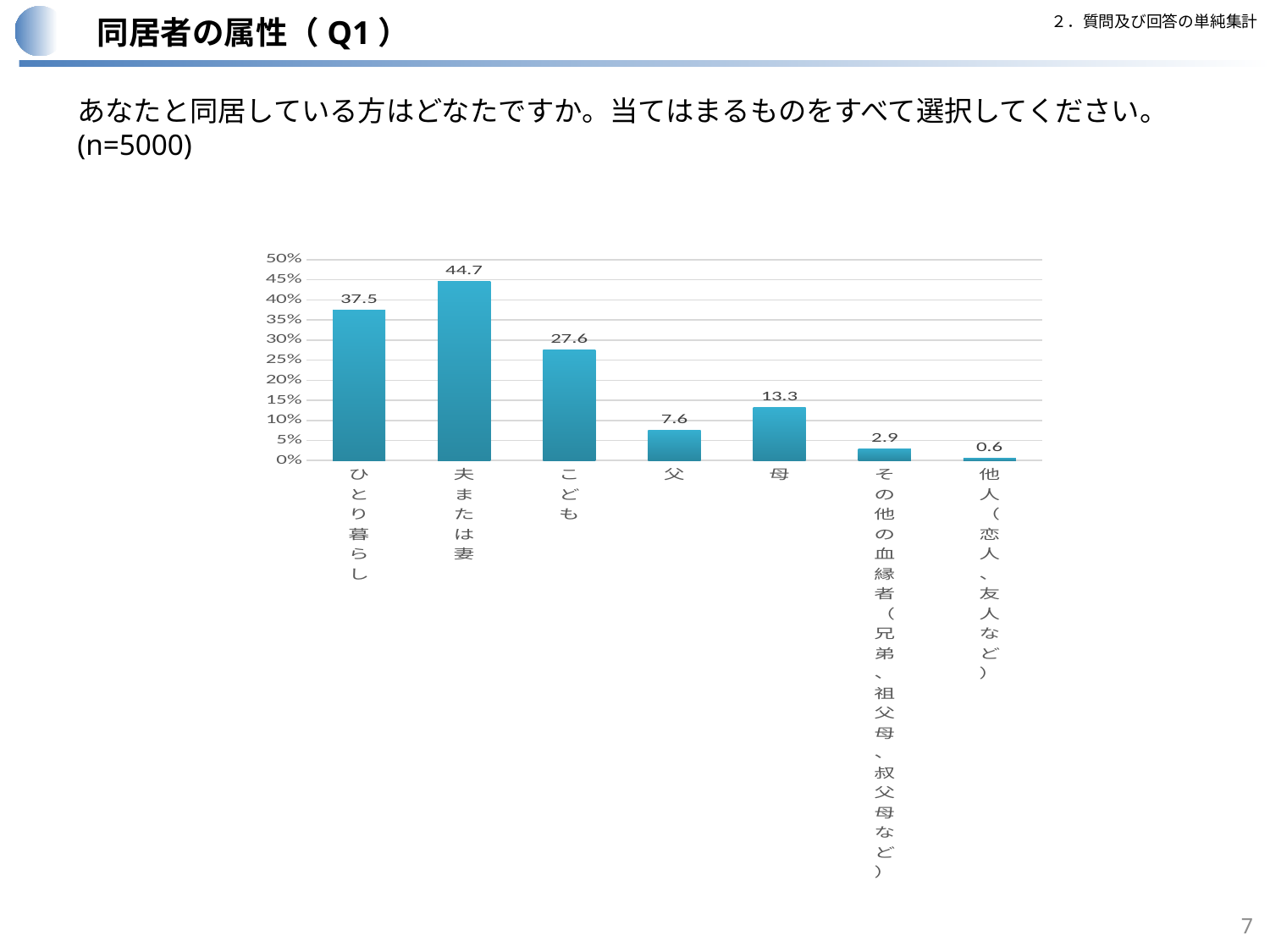
What kind of chart is shown on the slide? bar chart Is the value for こども greater or less than 25%? greater Which category has the highest value? 夫または妻 How many categories are shown in the chart? 7 What is the value for 母? 13.3 Which is larger, the value for 父 or the value for 母? 母 What is the sample size (n) stated on the slide? 5000 What is the value for ひとり暮らし? 37.5 What is the value for こども? 27.6 What is the value for 夫または妻? 44.7 Which category has the lowest value? 他人（恋人、友人など） What is the difference between the values for 夫または妻 and ひとり暮らし? 7.2